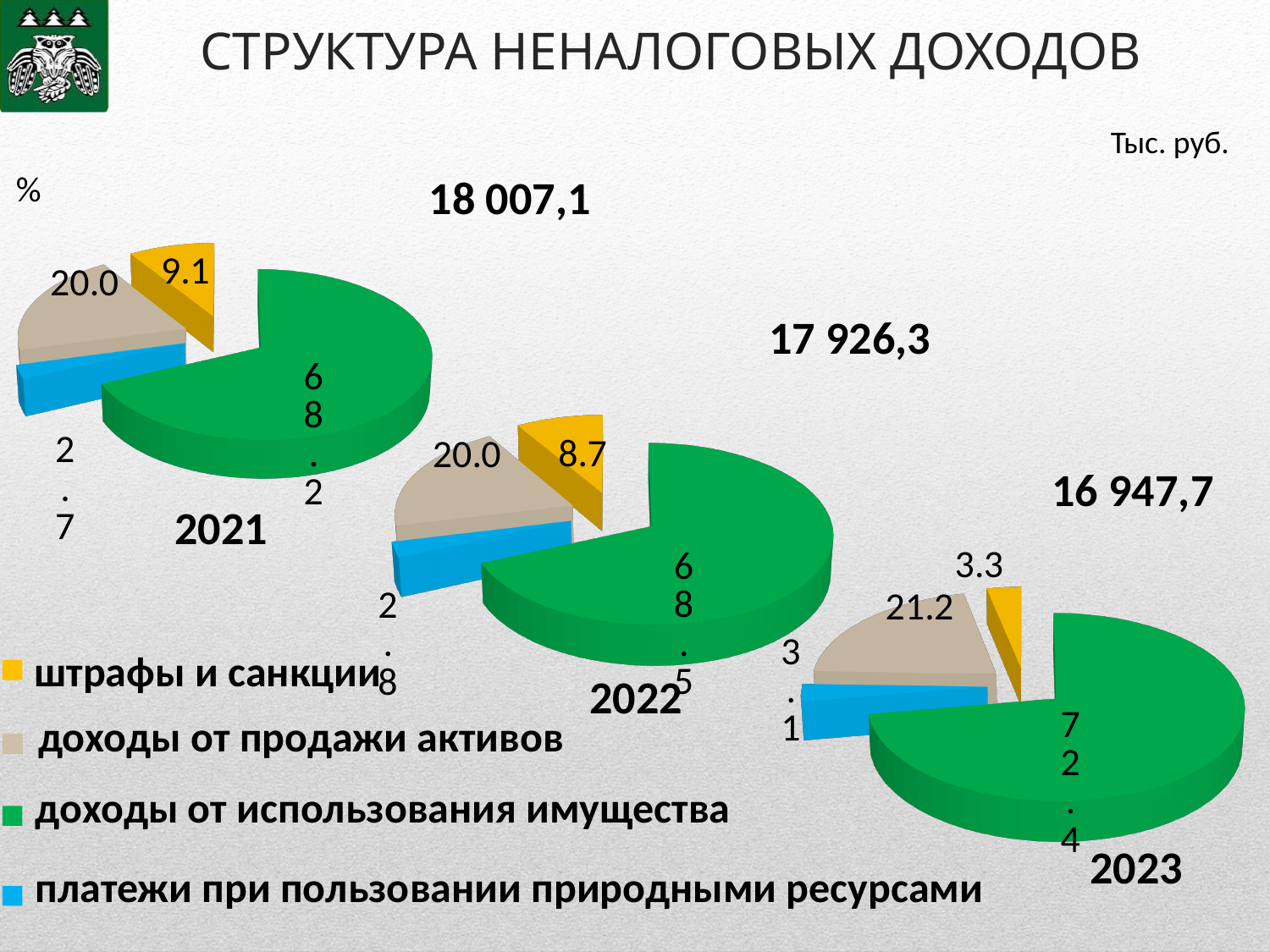
In the 2023 pie chart, what share is shown for платежи при пользовании природными ресурсами? 3.1 What is the difference between the share for доходы от использования имущества in 2023 and in 2021? 4.2 How many categories does the legend list? 4 What type of chart is used to show the structure of non-tax revenues for each year? pie chart What total value (тыс. руб.) is printed above the 2022 pie chart? 17 926,3 In the 2022 pie chart, what share is shown for штрафы и санкции? 8.7 In the 2022 pie chart, which category has the smallest share? платежи при пользовании природными ресурсами What total value (тыс. руб.) is printed above the 2023 pie chart? 16 947,7 In the 2021 pie chart, what share is shown for доходы от использования имущества? 68.2 In the 2023 pie chart, what share is shown for доходы от продажи активов? 21.2 In the 2023 pie chart, which is larger: the share for штрафы и санкции or the share for доходы от продажи активов? доходы от продажи активов In the 2021 pie chart, which category has the largest share? доходы от использования имущества